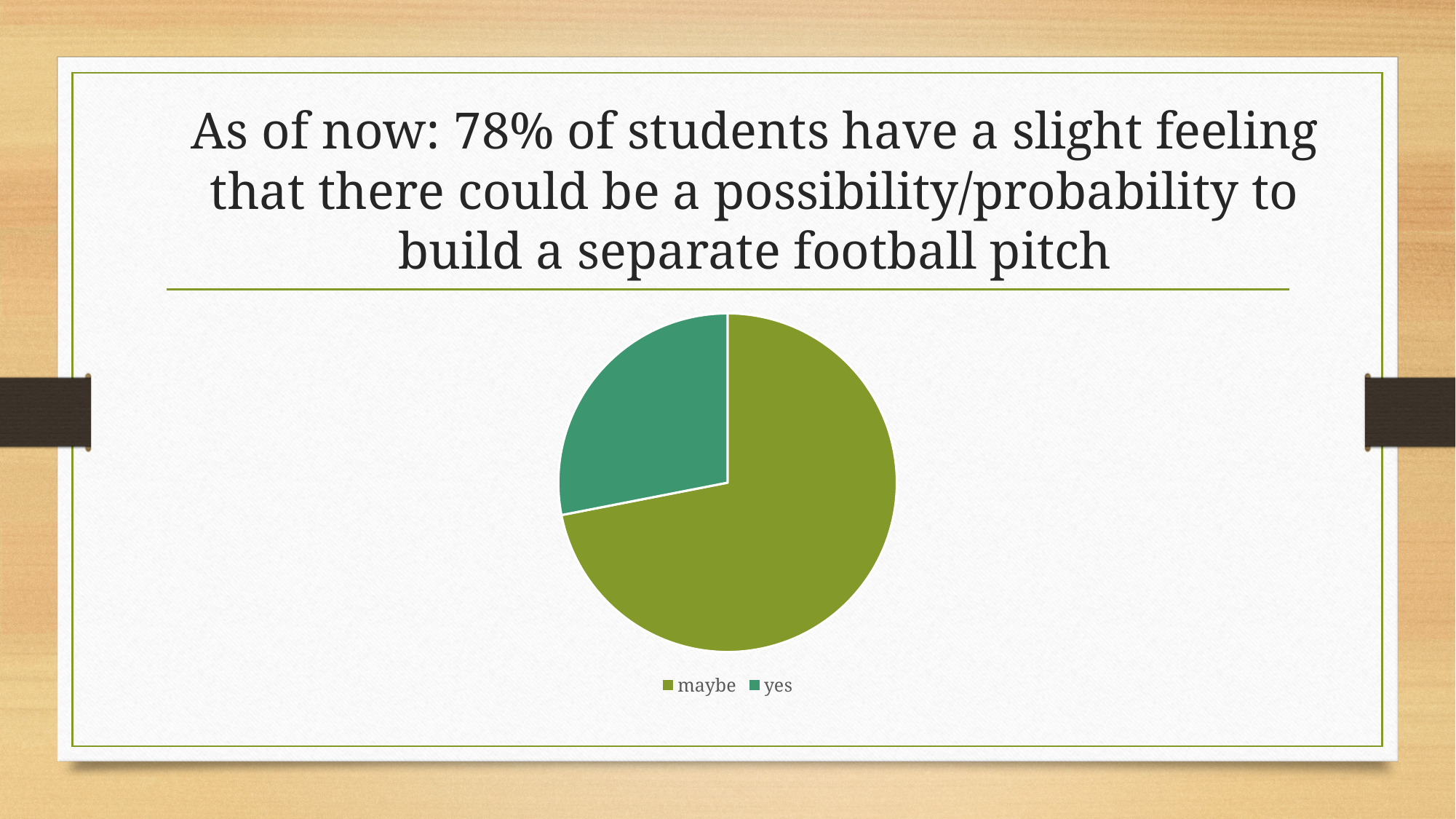
How many slices does the pie chart have? 2 Which slice is larger in the pie chart, "maybe" or "yes"? maybe What kind of chart is shown on the slide? pie chart What are the two categories listed in the legend of the pie chart? maybe and yes Which slice of the pie chart is the smallest? yes What colour is the "yes" slice in the pie chart? teal How many entries does the legend of the pie chart list? 2 Which slice of the pie chart is the largest? maybe